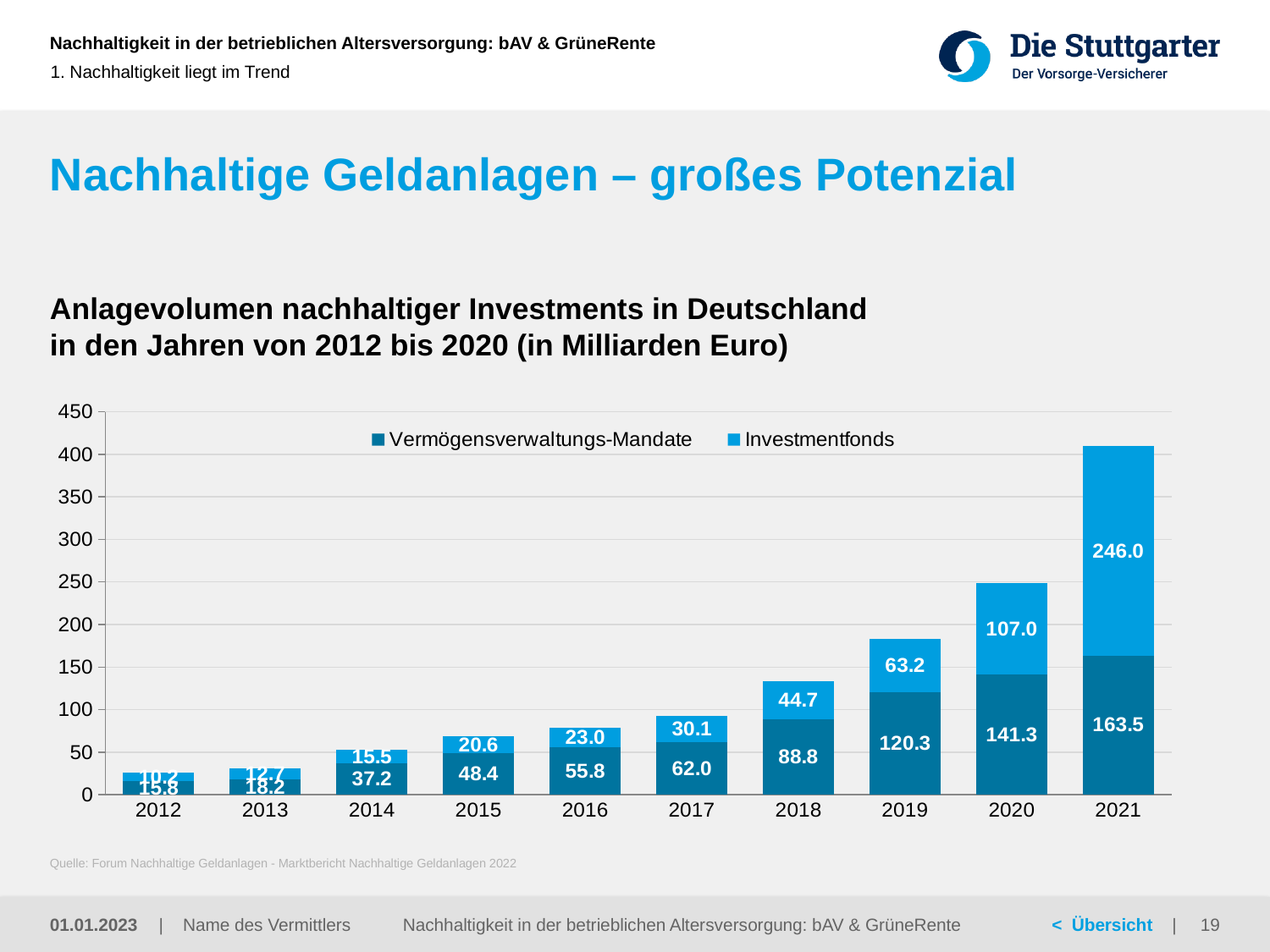
In 2021, which series has the larger value, Vermögensverwaltungs-Mandate or Investmentfonds? Investmentfonds Which year has the highest total stacked bar? 2021 How many years are shown on the x axis? 10 What type of chart is shown on the slide? Stacked bar chart What is the difference between Vermögensverwaltungs-Mandate in 2020 and in 2018? 52.5 How many series does the legend list? 2 What is the value for Vermögensverwaltungs-Mandate in 2019? 120.3 What is the value for Investmentfonds in 2021? 246.0 What is the value for Investmentfonds in 2017? 30.1 Is the total stacked bar for 2021 greater or less than 400? greater Do the total values rise or fall from 2012 to 2021? Rise What is the total of the stacked bar for 2020? 248.3